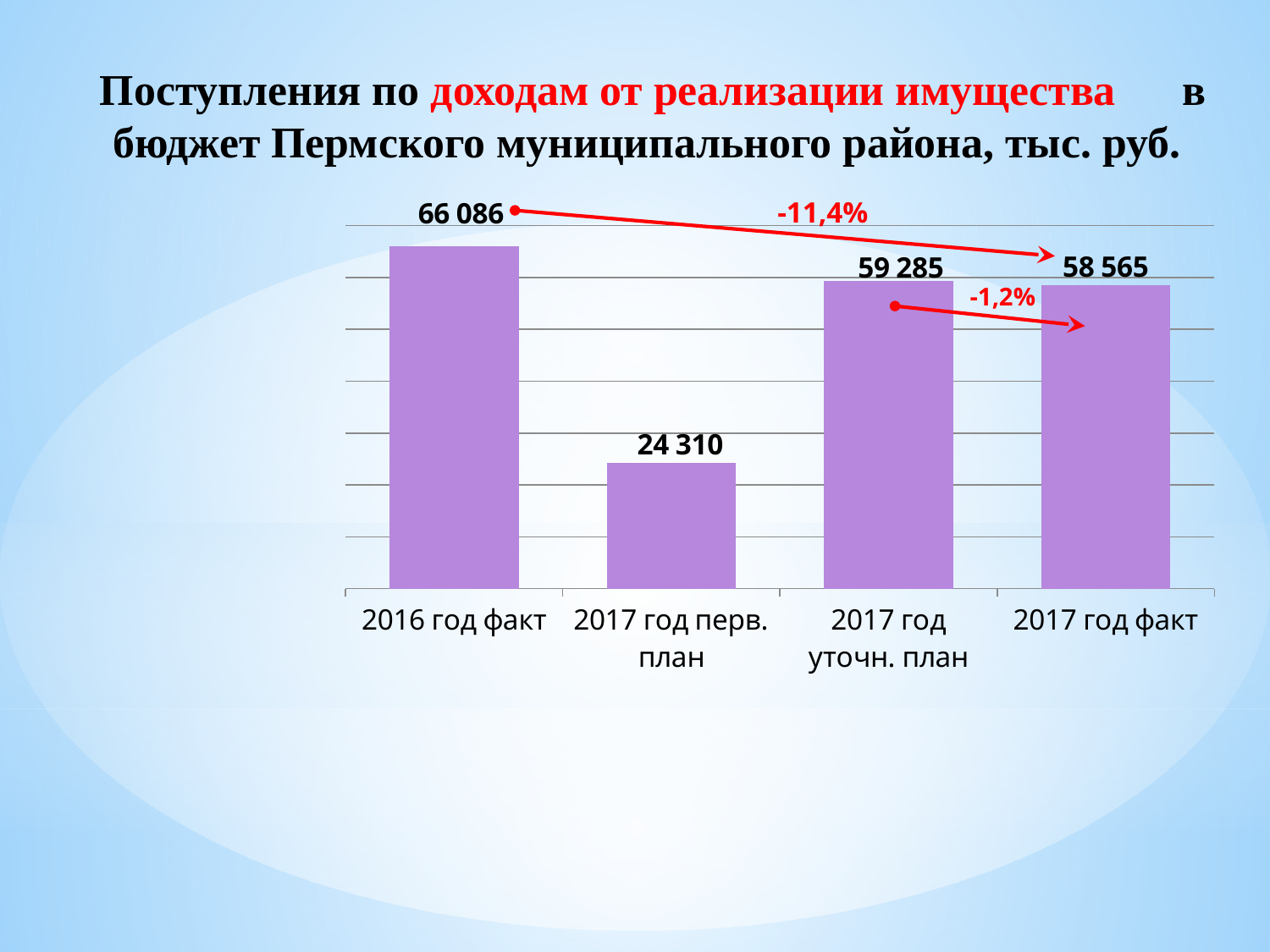
What is the difference between the values for 2017 год уточн. план and 2017 год факт? 720 What is the value for 2017 год перв. план? 24 310 What kind of chart is shown on the slide? Bar chart What is the value for 2016 год факт? 66 086 What percentage change is annotated between 2016 год факт and 2017 год факт? -11,4% Which category has the lowest value? 2017 год перв. план What is the value for 2017 год уточн. план? 59 285 Which category has the highest value? 2016 год факт How many bars are shown in the chart? 4 What is the value for 2017 год факт? 58 565 What is the difference between the values for 2016 год факт and 2017 год факт? 7 521 Which is larger, the value for 2017 год уточн. план or the value for 2017 год перв. план? 2017 год уточн. план